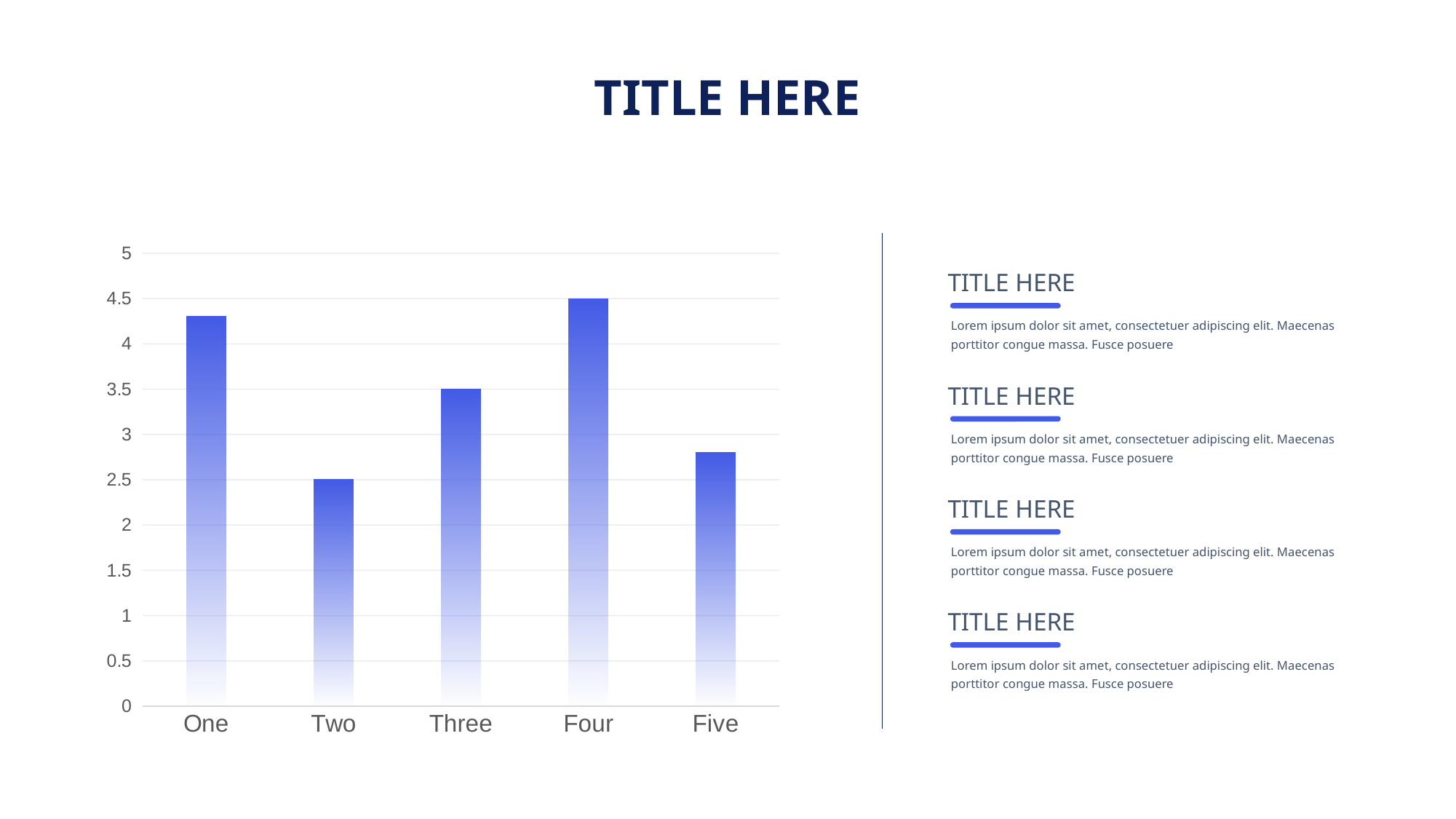
Is the value for Five greater or less than 3? less How many categories are shown on the x axis? 5 What is the difference between the values for Four and Two? 2 What is the difference between the values for Three and Two? 1 What is the value for Four? 4.5 Which is larger, the value for Three or the value for Five? Three What kind of chart is shown on the slide? bar chart Which category has the highest value? Four Is the value for One greater or less than 4? greater Which category has the lowest value? Two What is the value for Three? 3.5 What is the value for Two? 2.5